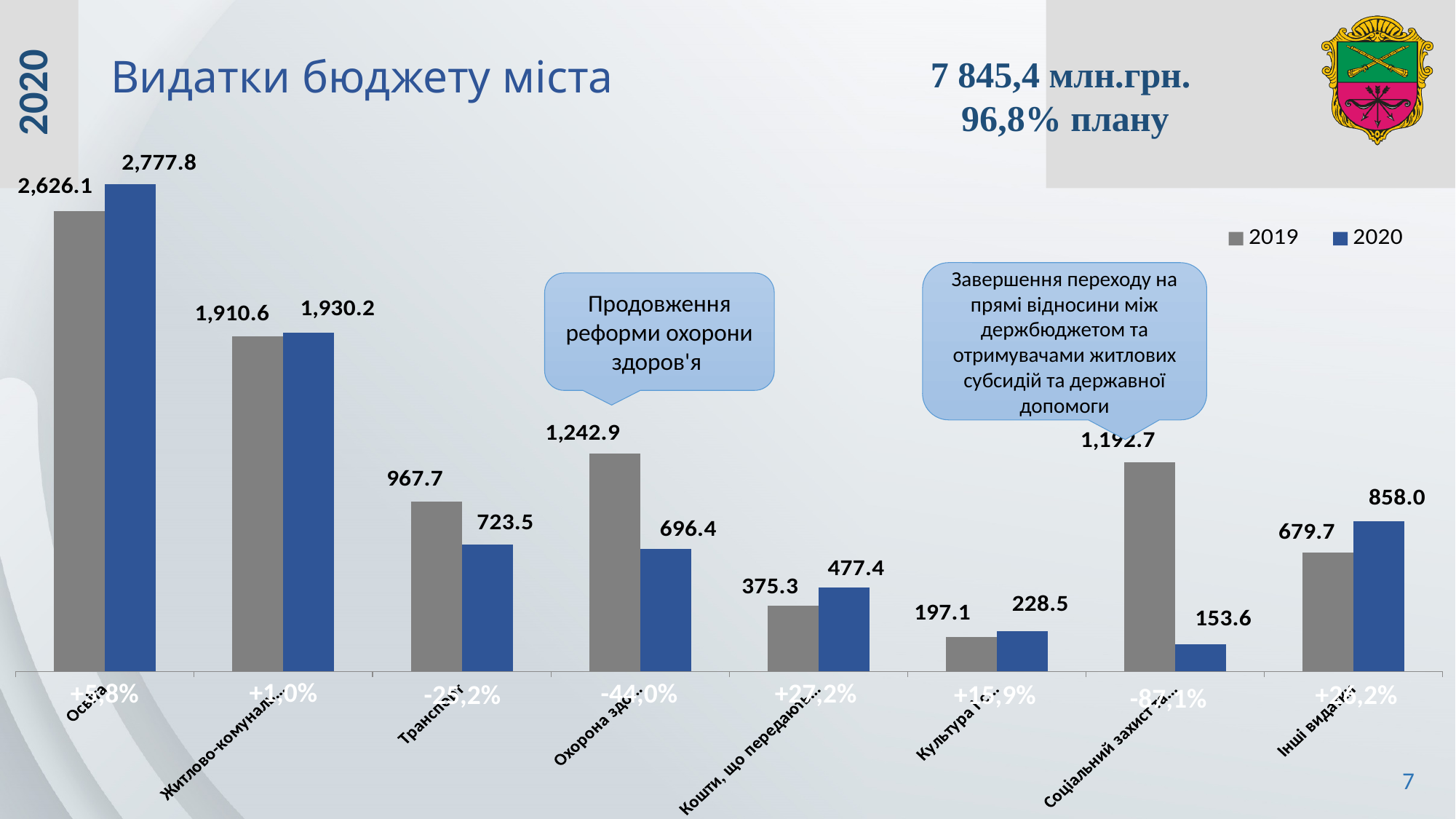
What kind of chart is shown on the slide? Bar chart Which category has the highest 2020 value? Освіта What is the difference between the 2019 and 2020 values for Інші видатки? 178.3 Which category has the lowest 2019 value? Культура What is the 2019 value for Транспорт? 967.7 Which colour represents the 2019 series in the legend? Grey Which is larger for Транспорт: the 2019 value or the 2020 value? 2019 What is the 2019 value for Охорона здоров'я? 1,242.9 How many series does the legend list? 2 How many categories are shown on the x axis? 8 What is the 2020 value for Освіта? 2,777.8 What is the 2020 value for Соціальний захист? 153.6